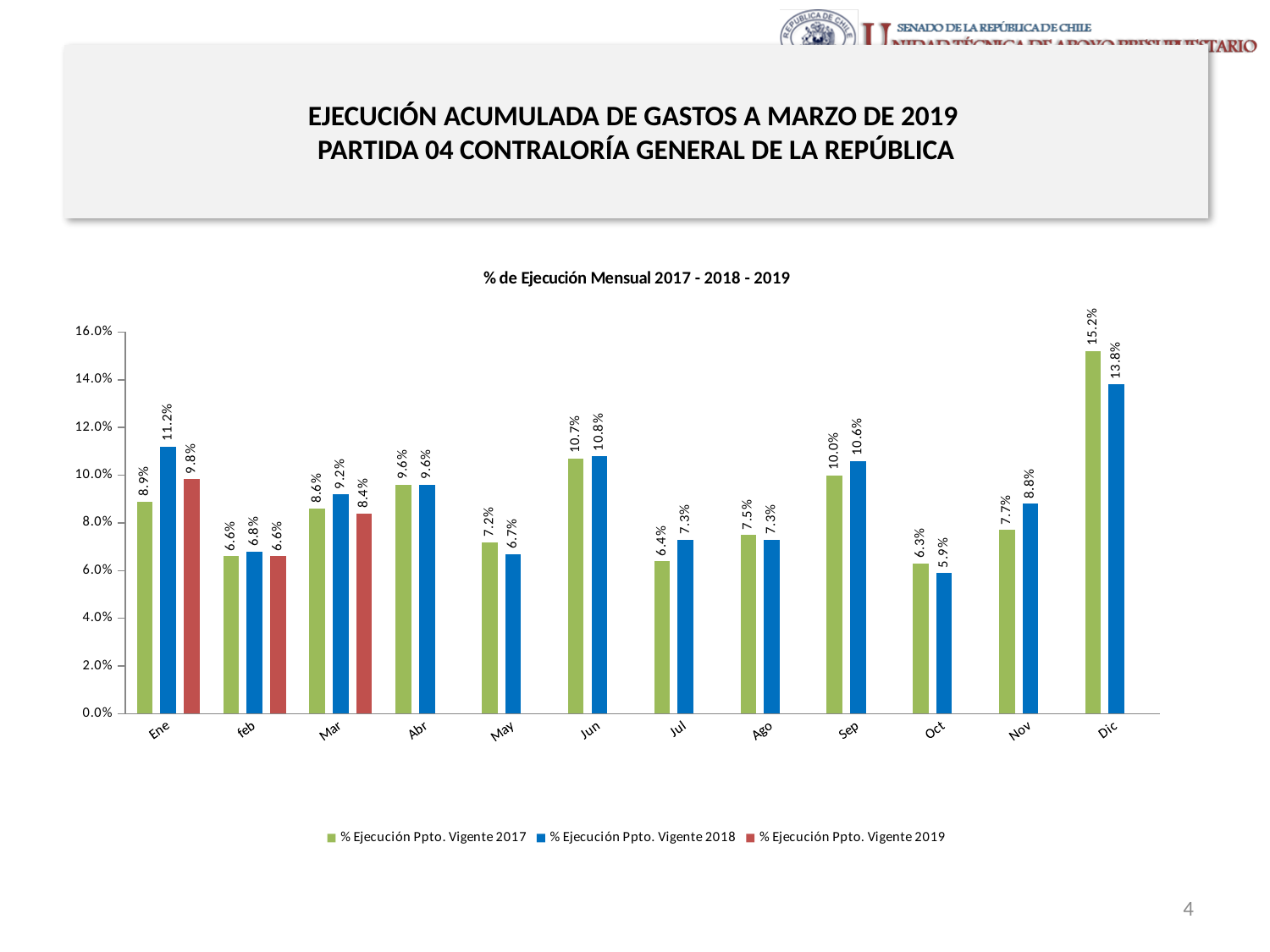
How many months are shown on the x axis? 12 Which month has the lowest value for % Ejecución Ppto. Vigente 2018? Oct How many series does the legend list? 3 Is the value for % Ejecución Ppto. Vigente 2017 in Dic greater or less than 14.0%? greater What is the title of the chart? % de Ejecución Mensual 2017 - 2018 - 2019 What is the value for % Ejecución Ppto. Vigente 2017 in Sep? 10.0% What kind of chart is shown on the slide? Bar chart In Mar, which is larger: the 2018 value or the 2019 value? 2018 Which month has the highest value for % Ejecución Ppto. Vigente 2017? Dic What is the value for % Ejecución Ppto. Vigente 2019 in Ene? 9.8% What is the value for % Ejecución Ppto. Vigente 2018 in Dic? 13.8% What is the difference between the 2018 and 2017 values in Ene? 2.3%